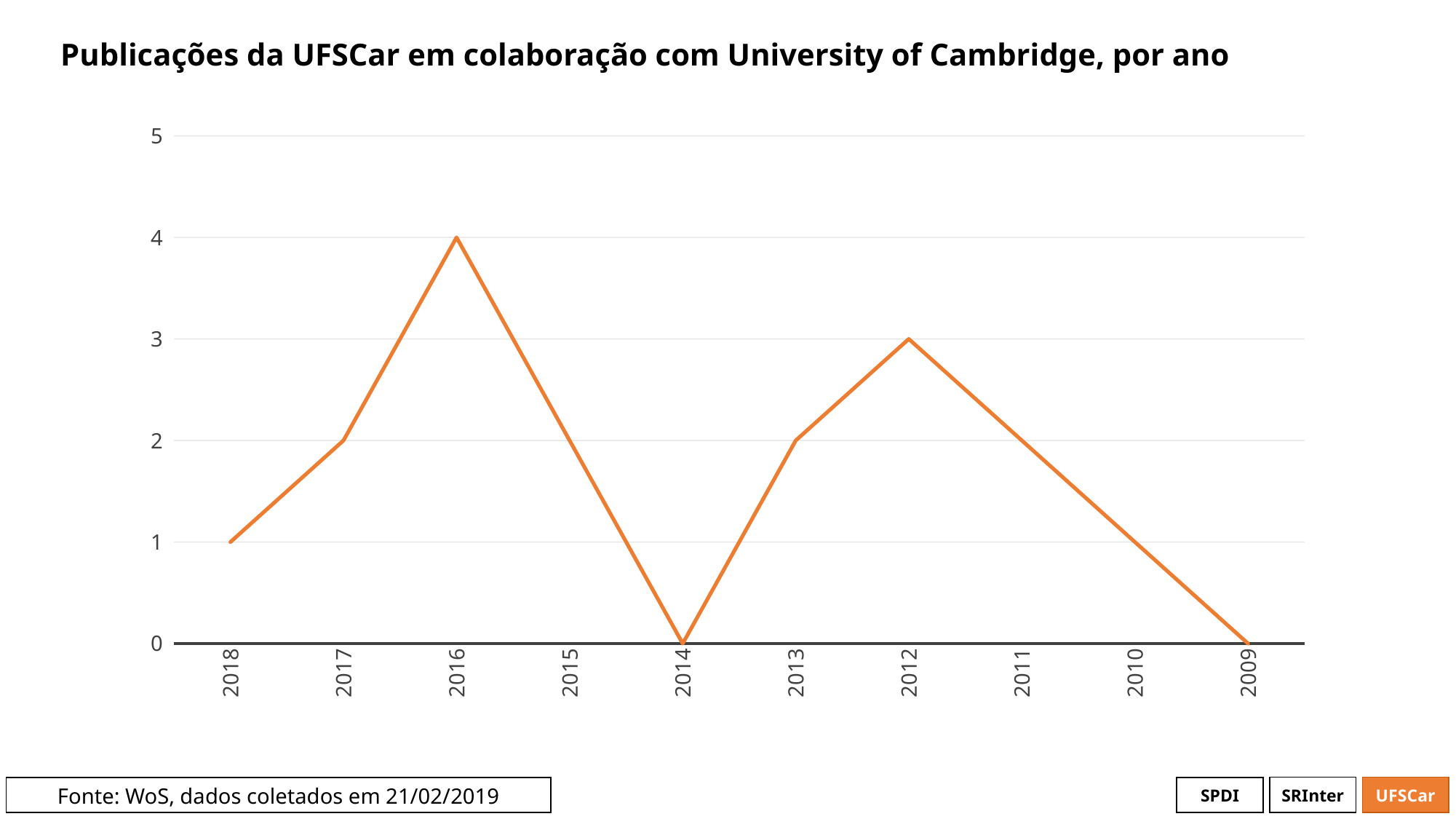
What is the number of publications in 2018? 1 What is the title of the chart? Publicações da UFSCar em colaboração com University of Cambridge, por ano What is the number of publications in 2016? 4 How many years are shown on the x axis? 10 Which year has the highest number of publications? 2016 What is the number of publications in 2012? 3 What kind of chart is shown on the slide? line chart Is the value for 2016 greater or less than 3? greater What is the difference between the values for 2016 and 2012? 1 Which year has the larger value, 2016 or 2018? 2016 Which year has the larger value, 2017 or 2013? They are equal (2) What is the number of publications in 2014? 0